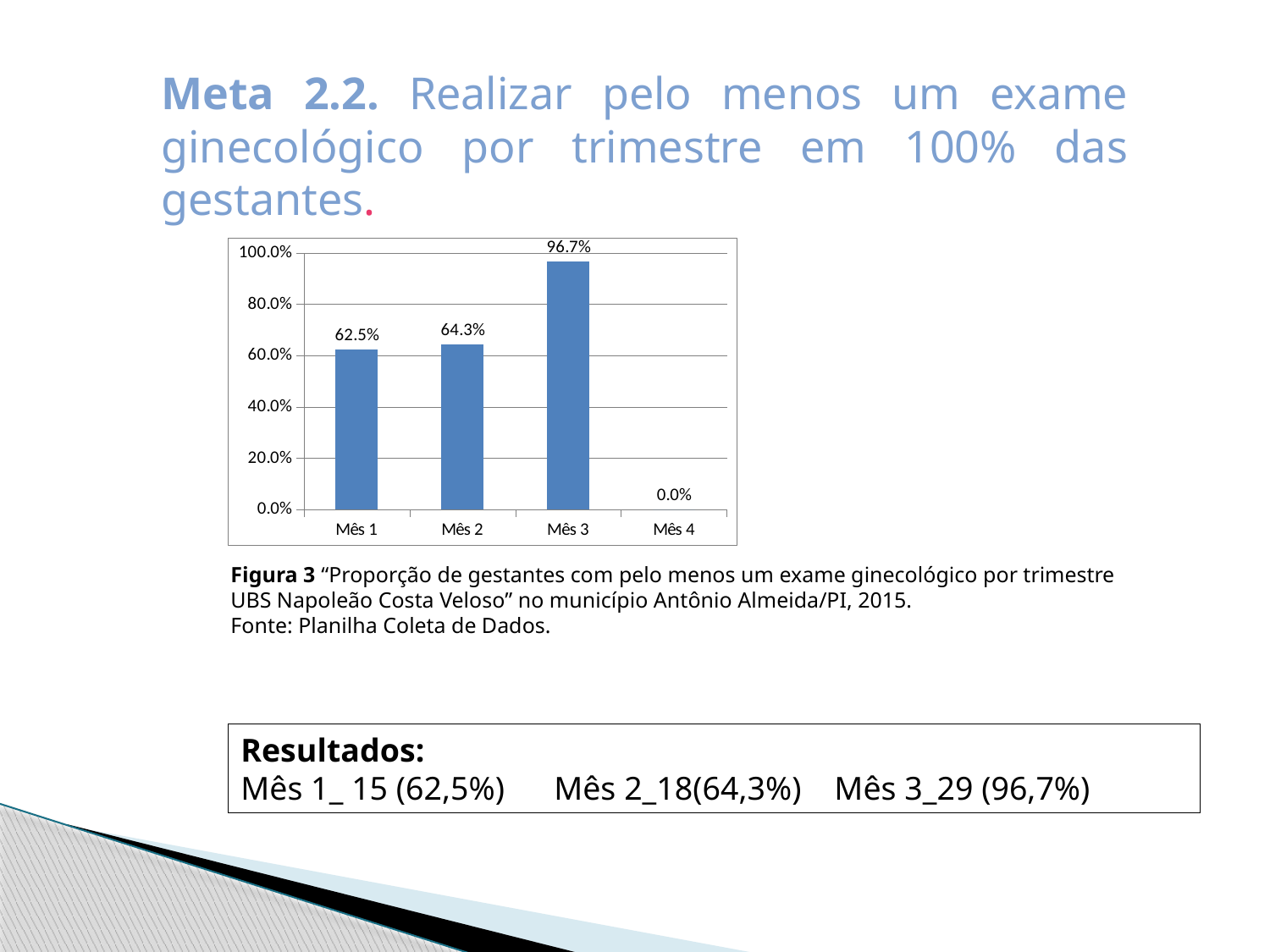
Which is larger, the value for Mês 3 or the value for Mês 2? Mês 3 What is the value for Mês 4? 0.0% Is the value for Mês 3 greater or less than 80.0%? greater What is the value for Mês 3? 96.7% What is the value for Mês 2? 64.3% How many months are shown on the x axis? 4 What is the value for Mês 1? 62.5% Which month has the highest value? Mês 3 What kind of chart is shown on the slide? bar chart Which month has the lowest value? Mês 4 What is the difference between the values for Mês 3 and Mês 1? 34.2% What colour are the bars in the chart? blue